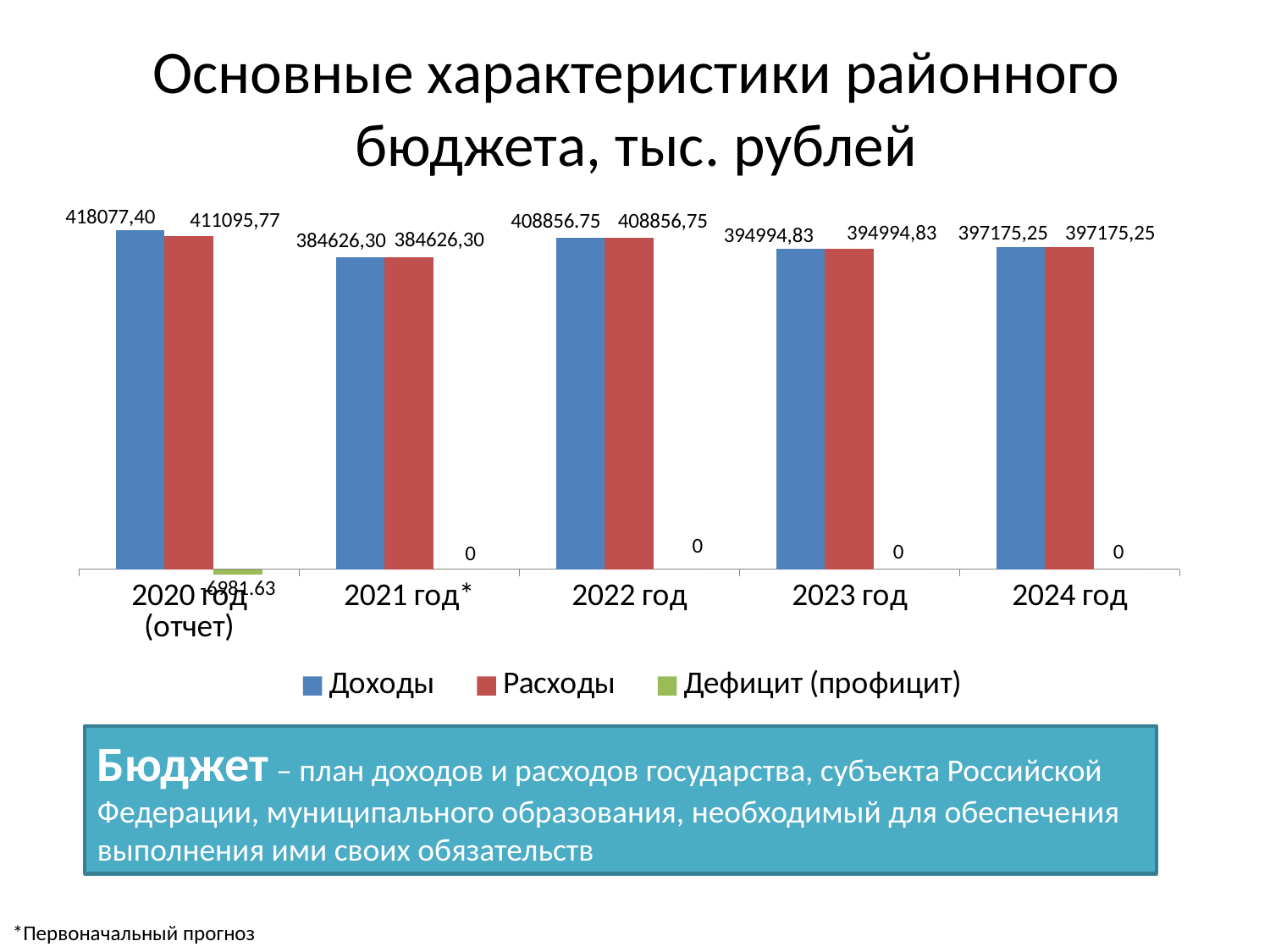
What is the difference between Доходы and Расходы for 2020 год (отчет)? 6981,63 How many series does the legend list? 3 What is the value of Расходы for 2023 год? 394994,83 In which year is Доходы the highest? 2020 год (отчет) What kind of chart is shown on the slide? Bar chart In which year is Доходы the lowest? 2021 год* What is the value of Расходы for 2020 год (отчет)? 411095,77 What is the value of Дефицит (профицит) for 2024 год? 0 What is the value of Доходы for 2021 год*? 384626,30 How many years are shown on the x axis? 5 What is the value of Доходы for 2020 год (отчет)? 418077,40 Which is larger for 2020 год (отчет): Доходы or Расходы? Доходы